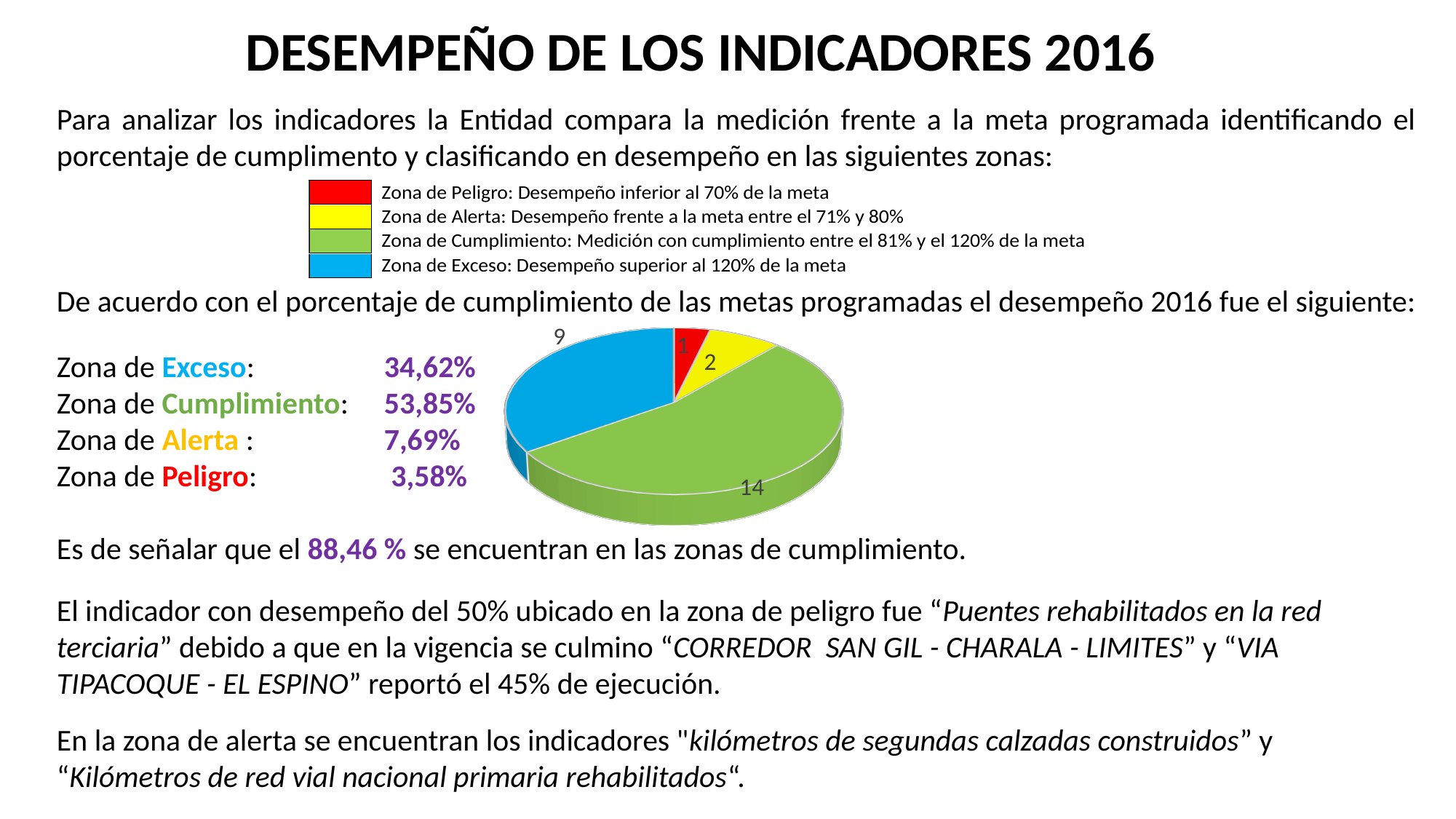
What kind of chart is shown on the slide? pie chart What value is labelled on the red slice of the pie chart? 1 Which slice of the pie chart has the largest value? green (14) Which slice of the pie chart has the smallest value? red (1) Which is larger in the pie chart, the blue slice or the yellow slice? blue What is the total of all the slice values in the pie chart? 26 What value is labelled on the green slice of the pie chart? 14 How many slices does the pie chart have? 4 What share of the pie does the green slice represent, according to the percentage printed on the slide? 53,85% What value is labelled on the blue slice of the pie chart? 9 What value is labelled on the yellow slice of the pie chart? 2 What is the difference between the green slice and the blue slice in the pie chart? 5